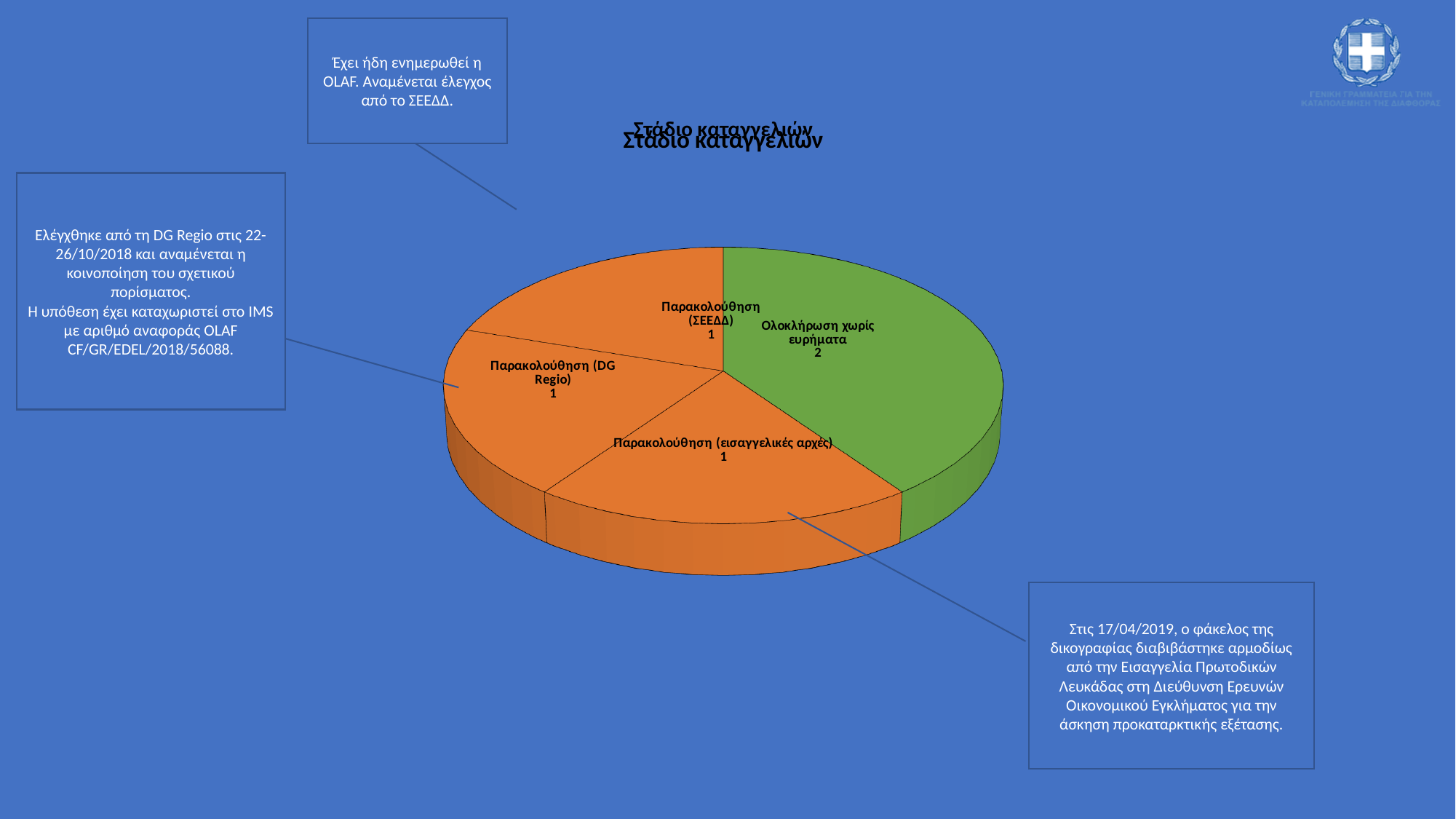
What is the value for Ολοκλήρωση χωρίς ευρήματα? 2 What is the value for Παρακολούθηση (ΣΕΕΔΔ)? 1 What is the difference between the values for Ολοκλήρωση χωρίς ευρήματα and Παρακολούθηση (ΣΕΕΔΔ)? 1 What kind of chart is shown on the slide? pie chart Which is larger, the value for Ολοκλήρωση χωρίς ευρήματα or the value for Παρακολούθηση (DG Regio)? Ολοκλήρωση χωρίς ευρήματα What share of the pie does Ολοκλήρωση χωρίς ευρήματα represent? 40% What is the total of all slices in the pie chart? 5 What is the value for Παρακολούθηση (DG Regio)? 1 Which category has the highest value? Ολοκλήρωση χωρίς ευρήματα How many slices does the pie chart have? 4 What is the value for Παρακολούθηση (εισαγγελικές αρχές)? 1 What is the title of the chart? Στάδιο καταγγελιών